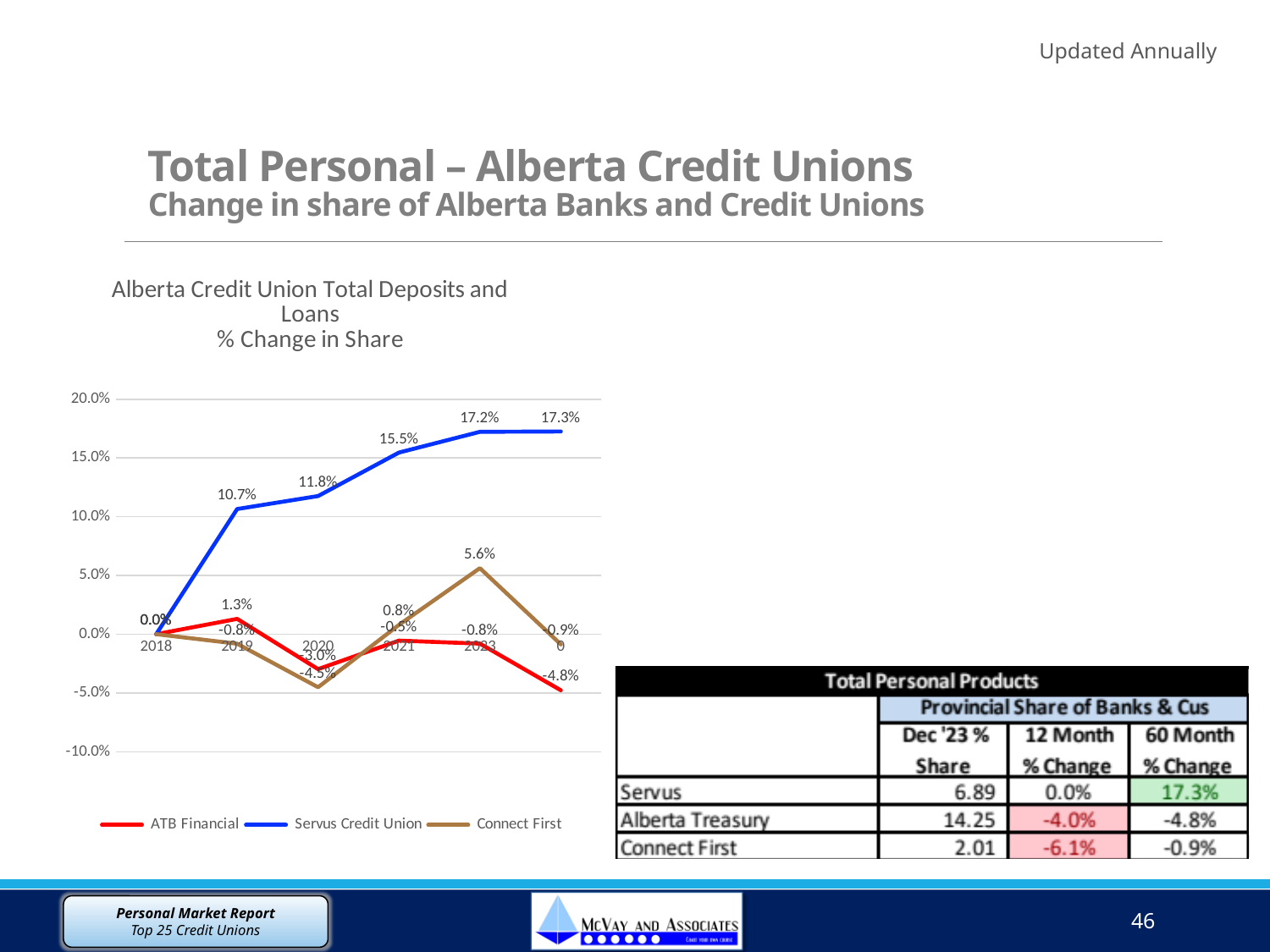
What is the difference between the Servus Credit Union values in 2023 and 2019? 6.5% Does the Servus Credit Union line rise or fall from 2018 to 2023? rises In 2023, which is larger: the value for ATB Financial or the value for Connect First? Connect First Is the value for Servus Credit Union in 2020 greater or less than 10.0%? greater Which series has the highest value in 2023? Servus Credit Union What is the value for ATB Financial in 2019? 1.3% What is the value for Connect First in 2023? 5.6% What type of chart is shown on the slide? line chart What is the value for Servus Credit Union in 2023? 17.2% What is the value for Servus Credit Union in 2019? 10.7% How many series does the chart legend list? 3 What is the value for Servus Credit Union in 2021? 15.5%